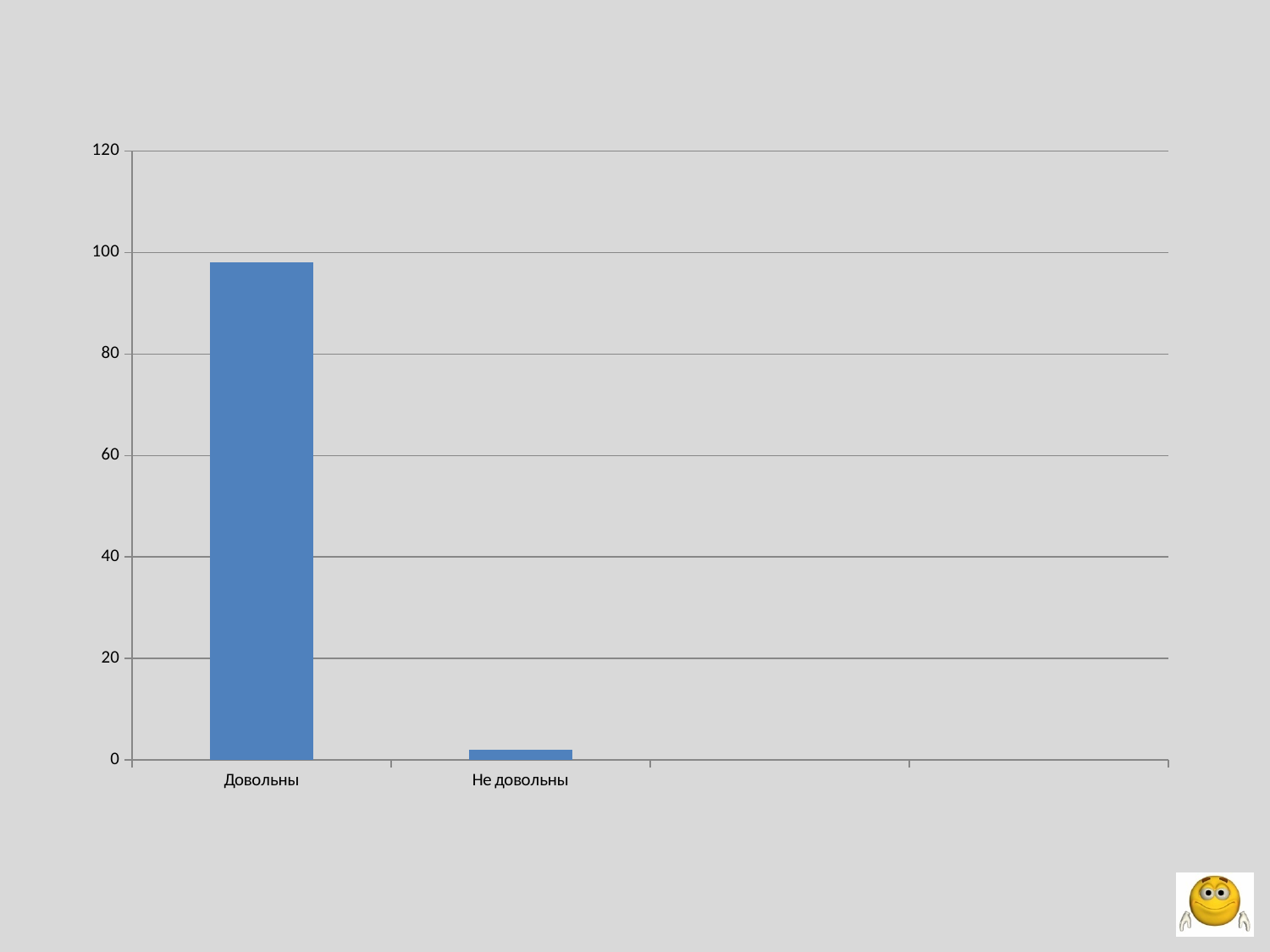
What kind of chart is shown on the slide? bar chart Do the values rise or fall from left to right along the x axis? fall Is the value for Не довольны greater or less than 20? less Is the value for Довольны greater or less than 80? greater What is the highest value shown on the vertical axis? 120 Is the value for Довольны greater or less than 60? greater What colour are the bars on the chart? blue How many categories are plotted on the chart? 2 Which category has the lowest value? Не довольны Which is larger, the value for Довольны or the value for Не довольны? Довольны Which category has the highest value? Довольны